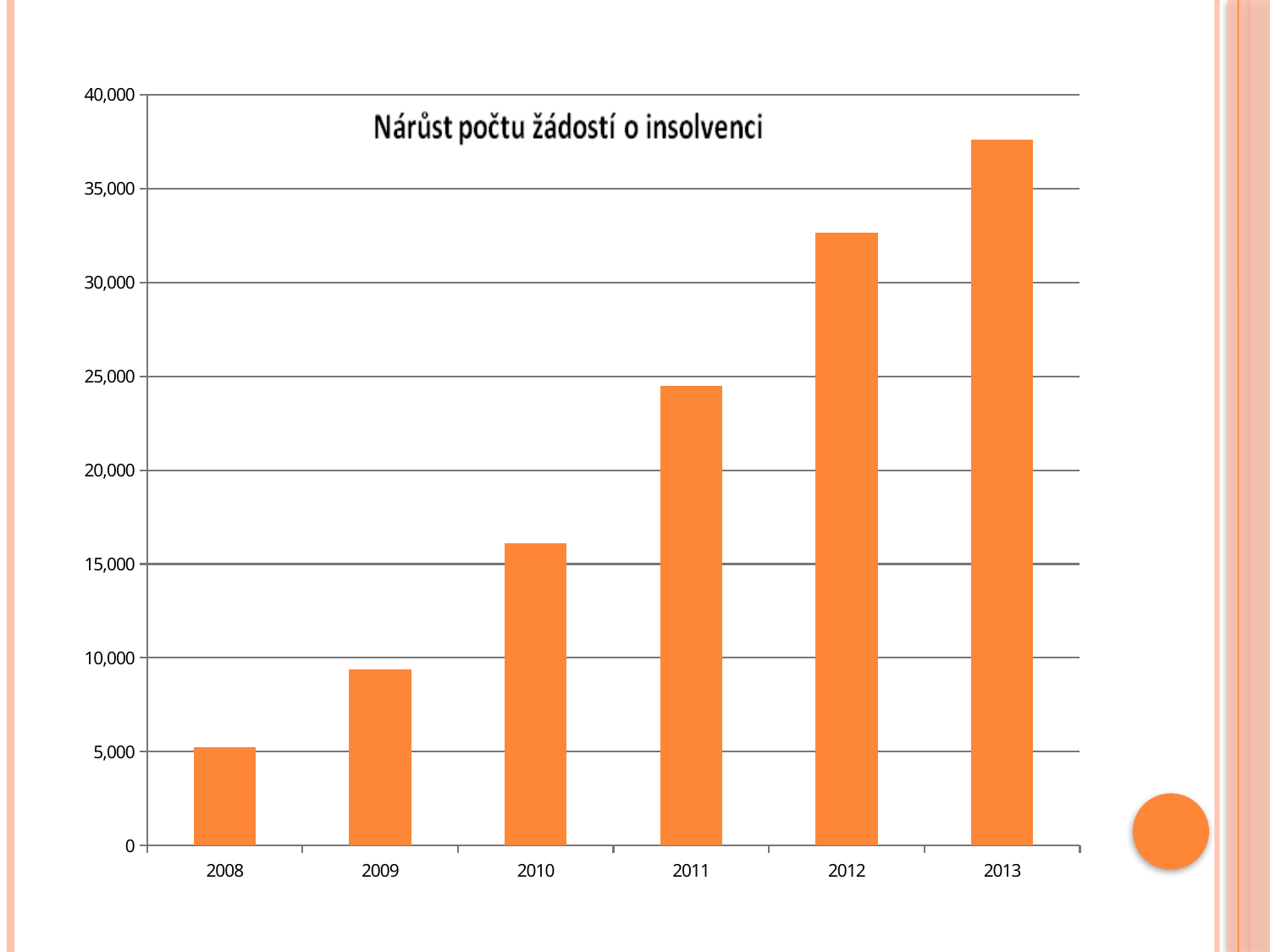
Is the value for 2013 greater or less than 35,000? greater What is the title of the chart? Nárůst počtu žádostí o insolvenci Is the value for 2011 greater or less than 20,000? greater Which is larger, the value for 2010 or the value for 2011? 2011 Do the values rise or fall from 2008 to 2013? rise What colour are the bars in the chart? orange Is the value for 2012 greater or less than 30,000? greater What kind of chart is shown on the slide? bar chart How many years are shown on the x axis of the chart? 6 Which year has the lowest bar? 2008 Which year has the highest bar? 2013